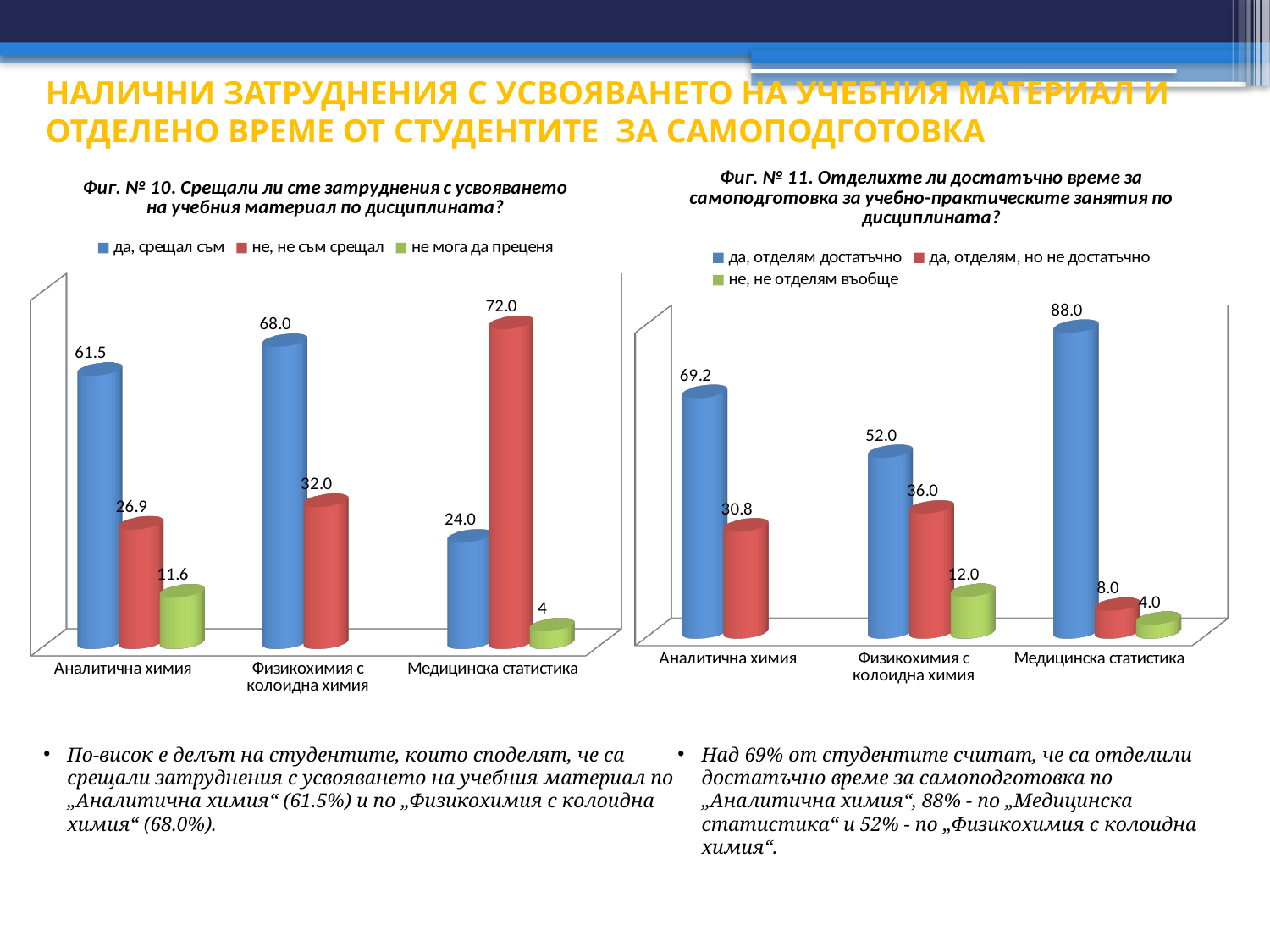
In the right chart (Фиг. № 11), what is the value for "да, отделям, но не достатъчно" for Физикохимия с колоидна химия? 36.0 How many categories are shown on the x axis of the right chart (Фиг. № 11)? 3 In the left chart (Фиг. № 10), what is the value for "не, не съм срещал" for Медицинска статистика? 72.0 In the left chart (Фиг. № 10), what is the difference between the "да, срещал съм" and "не, не съм срещал" values for Физикохимия с колоидна химия? 36.0 In the left chart (Фиг. № 10), what is the value for "да, срещал съм" for Аналитична химия? 61.5 What type of chart is the left chart (Фиг. № 10)? Bar chart In the right chart (Фиг. № 11), what is the value for "да, отделям достатъчно" for Медицинска статистика? 88.0 In the left chart (Фиг. № 10), which category has the highest value for "да, срещал съм"? Физикохимия с колоидна химия In the right chart (Фиг. № 11), which is larger: the "да, отделям достатъчно" value for Аналитична химия or for Медицинска статистика? Медицинска статистика In the left chart (Фиг. № 10), how many series does the legend list? 3 In the right chart (Фиг. № 11), what is the difference between the "да, отделям достатъчно" and "да, отделям, но не достатъчно" values for Аналитична химия? 38.4 In the right chart (Фиг. № 11), which category has the lowest value for "да, отделям достатъчно"? Физикохимия с колоидна химия